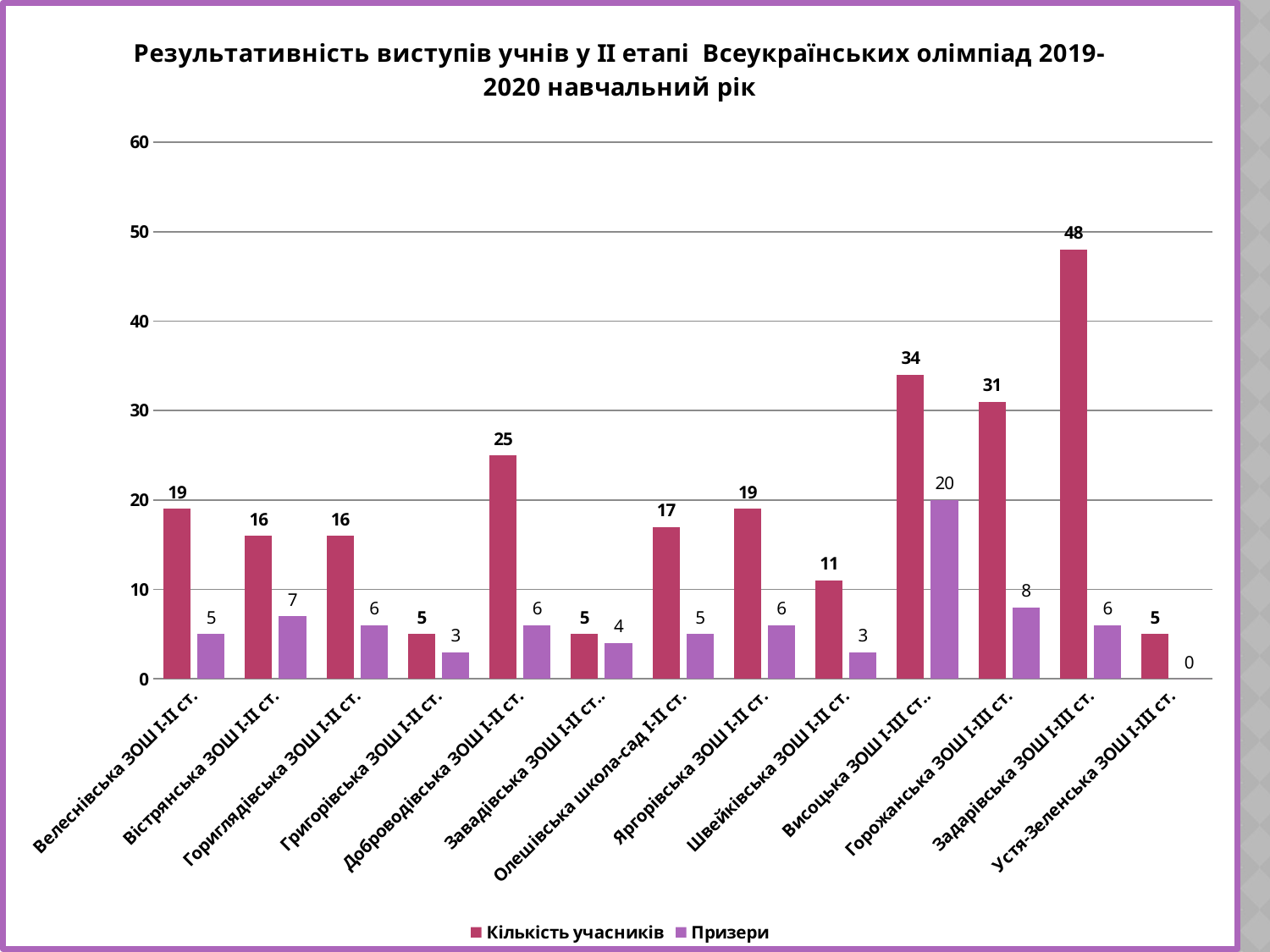
What is the value of "Призери" for Висоцька ЗОШ І-ІІІ ст.? 20 What is the difference between "Кількість учасників" and "Призери" for Висоцька ЗОШ І-ІІІ ст.? 14 Which school has the highest value for "Кількість учасників"? Задарівська ЗОШ І-ІІІ ст. Which is larger: "Кількість учасників" for Доброводівська ЗОШ І-ІІ ст. or for Олешівська школа-сад І-ІІ ст.? Доброводівська ЗОШ І-ІІ ст. What is the value of "Кількість учасників" for Задарівська ЗОШ І-ІІІ ст.? 48 How many series does the legend list? 2 How many schools are shown on the x axis? 13 Is the value of "Кількість учасників" for Горожанська ЗОШ І-ІІІ ст. greater or less than 30? greater What kind of chart is shown on the slide? Bar chart What is the value of "Призери" for Вістрянська ЗОШ І-ІІ ст.? 7 What is the value of "Призери" for Устя-Зеленська ЗОШ І-ІІІ ст.? 0 Which school has the lowest value for "Призери"? Устя-Зеленська ЗОШ І-ІІІ ст.